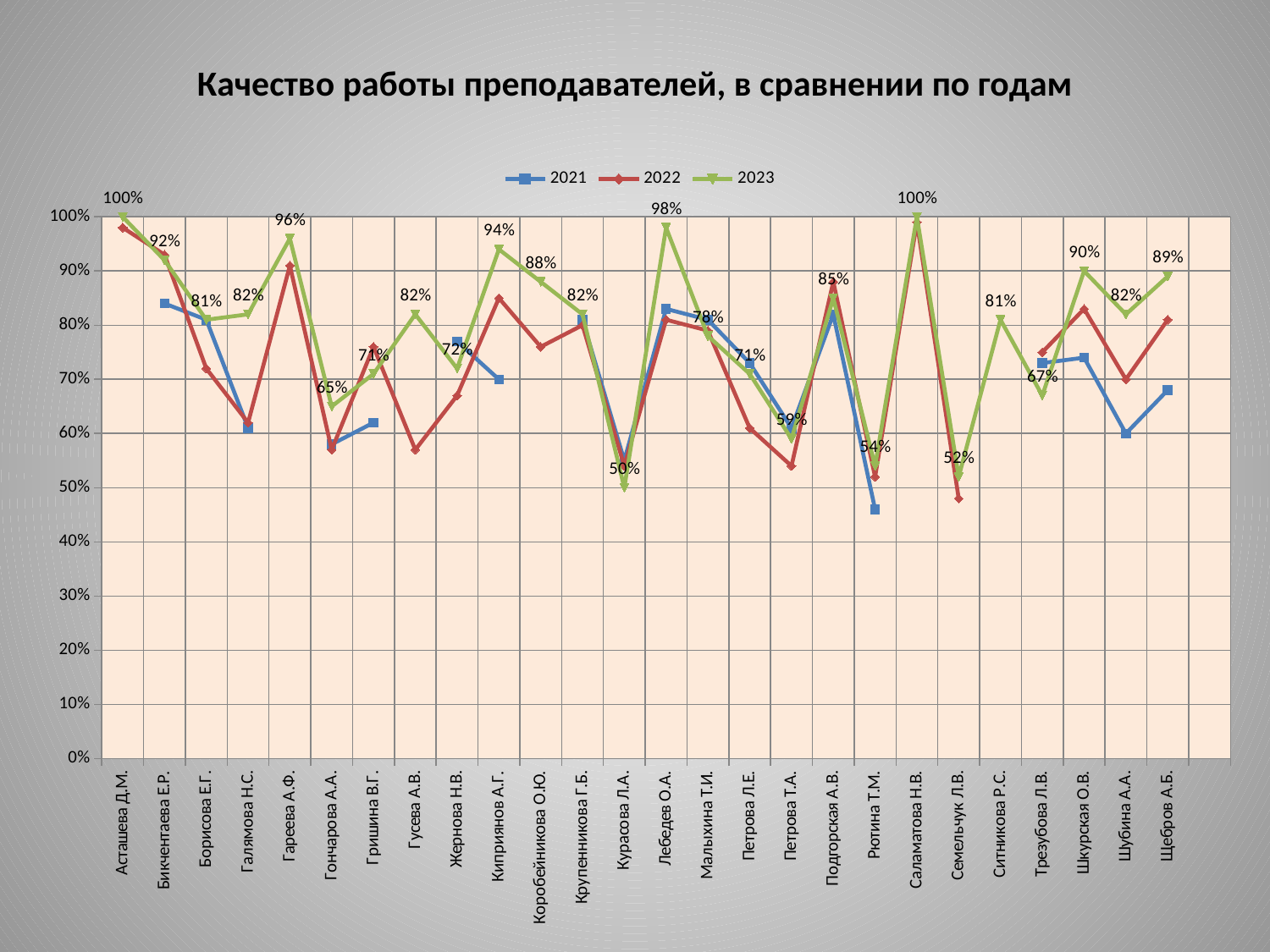
What is the title of the chart? Качество работы преподавателей, в сравнении по годам How many series does the legend list? 3 Is the 2021 value for Лебедев О.А. greater or less than 80%? greater Which teacher has the lowest 2023 value? Курасова Л.А. Is the 2022 value for Семельчук Л.В. greater or less than 50%? less What is the 2023 value for Шкурская О.В.? 90% What is the 2023 value for Курасова Л.А.? 50% What is the difference between the 2023 values for Лебедев О.А. and Курасова Л.А.? 48% What is the 2023 value for Лебедев О.А.? 98% Which is larger, the 2023 value for Гареева А.Ф. or for Киприянов А.Г.? Гареева А.Ф. What type of chart is shown on the slide? line chart What is the 2023 value for Гончарова А.А.? 65%